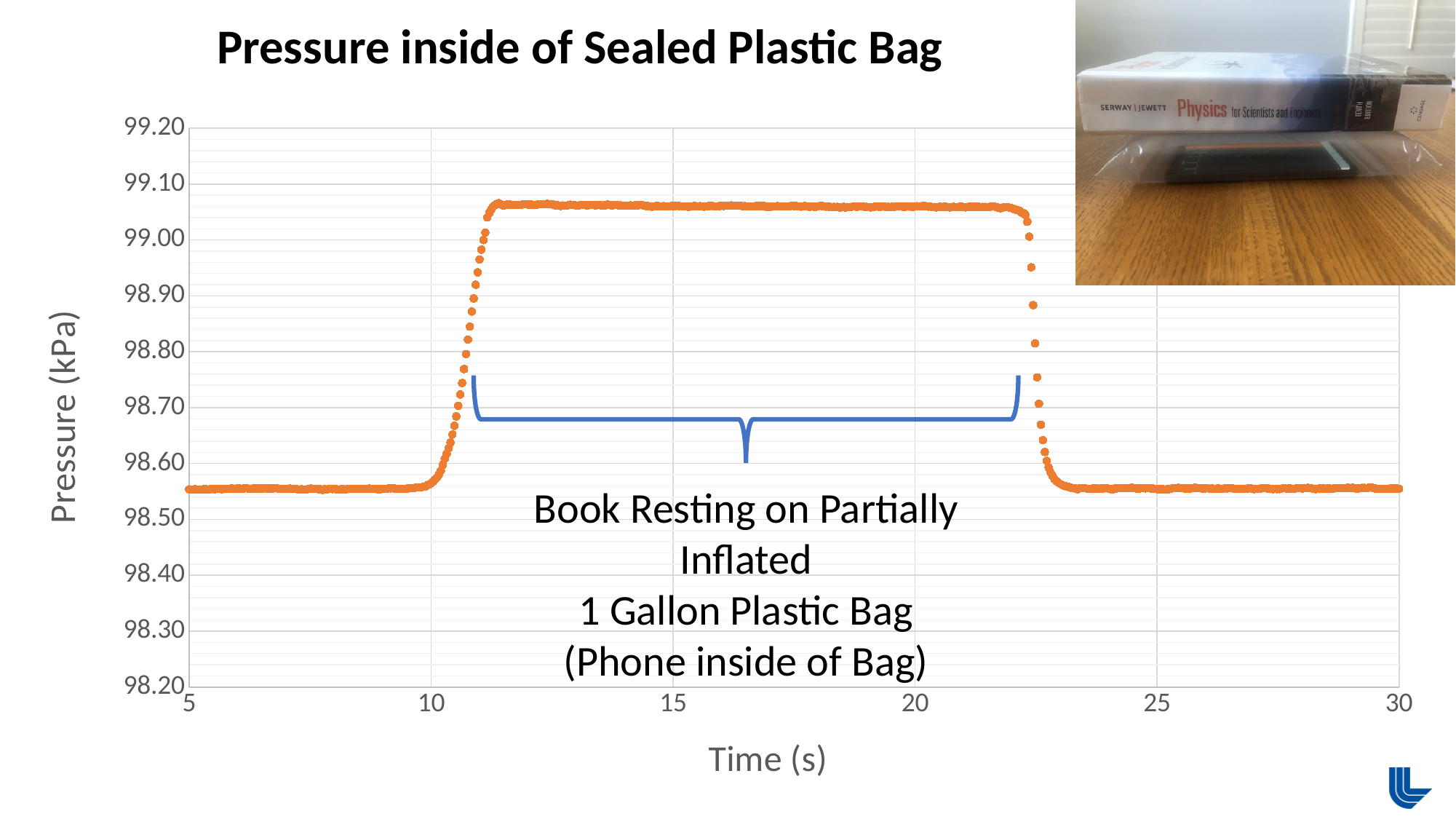
How many data series are plotted on the chart? 1 What kind of chart is shown on the slide? scatter chart What is the label of the y axis? Pressure (kPa) Does the pressure rise or fall between 22 s and 23 s? fall Is the pressure at 15 s greater or less than 99.00 kPa? greater Which is larger, the pressure at 15 s or the pressure at 7 s? the pressure at 15 s Is the pressure at 7 s greater or less than 98.60 kPa? less Is the pressure at 18 s greater or less than 98.90 kPa? greater Which is larger, the pressure at 27 s or the pressure at 20 s? the pressure at 20 s What is the title of the chart? Pressure inside of Sealed Plastic Bag Does the pressure rise or fall between 10 s and 11 s? rise